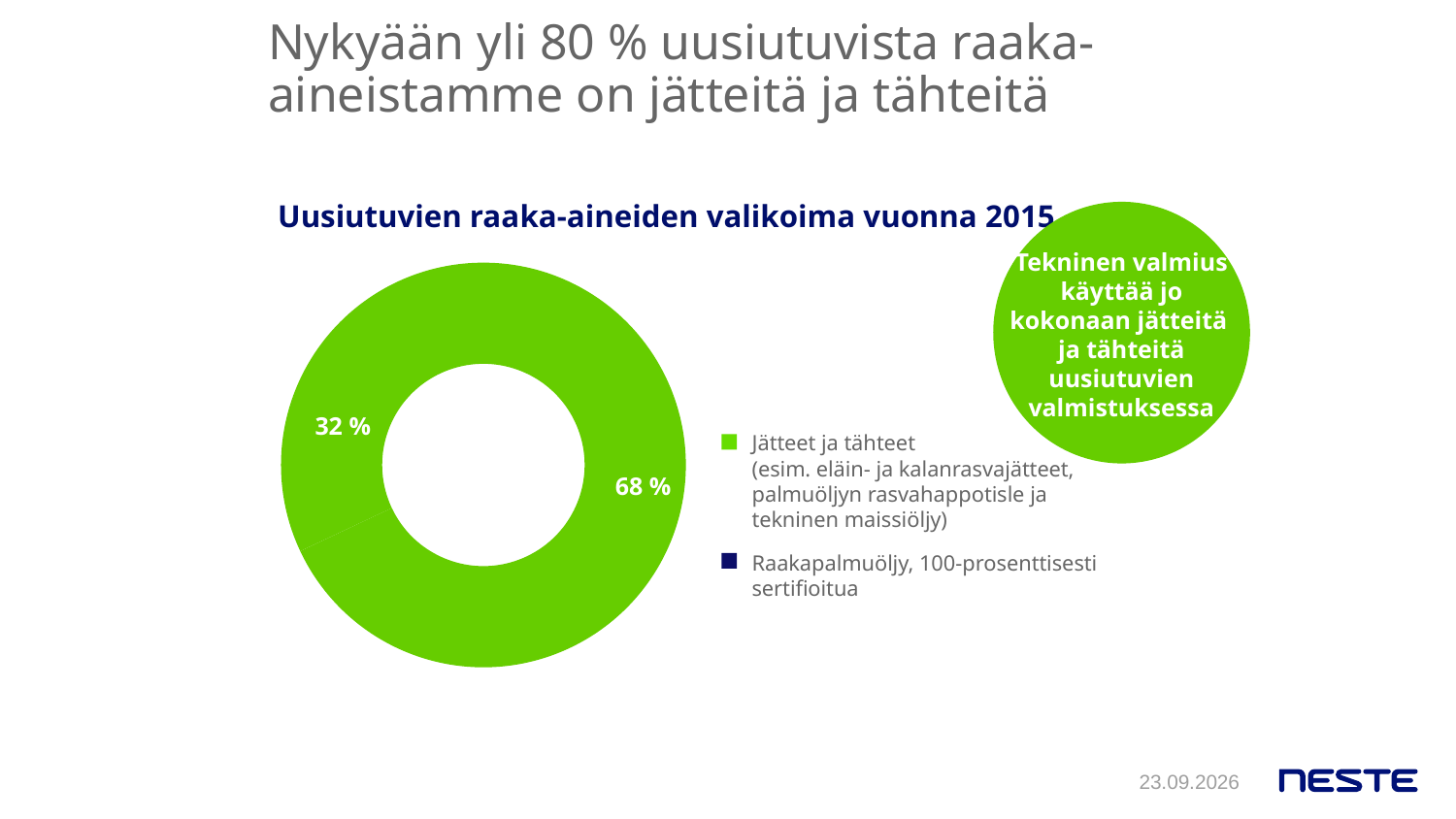
What is the larger percentage shown on the donut chart? 68 % What is the smaller percentage shown on the donut chart? 32 % What kind of chart is shown on the slide? Pie chart (donut) How many slices does the donut chart have? 2 Is the share labelled 68 % greater or less than 50 %? greater What colour is used for the Jätteet ja tähteet legend entry? Green Which is larger in the chart: Jätteet ja tähteet or Raakapalmuöljy? Jätteet ja tähteet What is the title of the chart? Uusiutuvien raaka-aineiden valikoima vuonna 2015 How many entries does the chart legend list? 2 What share of the chart is labelled for Raakapalmuöljy, 100-prosenttisesti sertifioitua? 32 % What share of the chart is labelled for Jätteet ja tähteet? 68 % What is the difference between the two percentages shown on the donut chart? 36 %